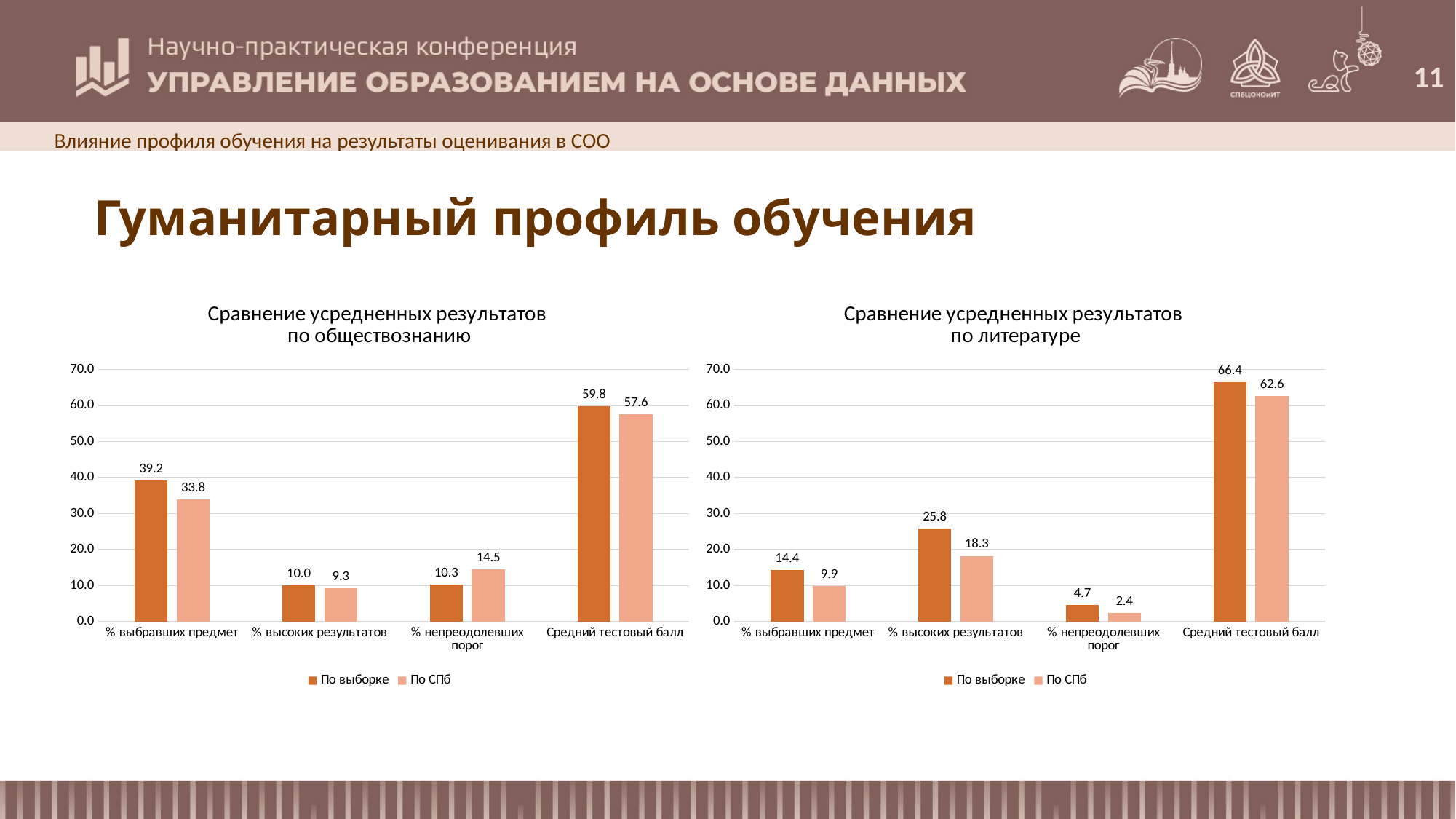
In the chart 'Сравнение усредненных результатов по обществознанию', what is the difference between 'По выборке' and 'По СПб' for '% выбравших предмет'? 5.4 In the chart 'Сравнение усредненных результатов по литературе', what is the difference between 'По выборке' and 'По СПб' for '% высоких результатов'? 7.5 In the chart 'Сравнение усредненных результатов по литературе', what is the value of 'По выборке' for '% непреодолевших порог'? 4.7 In the chart 'Сравнение усредненных результатов по обществознанию', what is the value of 'По выборке' for '% выбравших предмет'? 39.2 In the chart 'Сравнение усредненных результатов по литературе', which category has the lowest 'По СПб' value? % непреодолевших порог In the chart 'Сравнение усредненных результатов по литературе', is the 'По выборке' value for 'Средний тестовый балл' greater or less than 60.0? greater In the chart 'Сравнение усредненных результатов по обществознанию', which is larger for '% непреодолевших порог': 'По выборке' or 'По СПб'? По СПб What type of chart is 'Сравнение усредненных результатов по литературе'? Bar chart How many series does the legend of the chart 'Сравнение усредненных результатов по литературе' list? 2 In the chart 'Сравнение усредненных результатов по обществознанию', which category has the highest 'По выборке' value? Средний тестовый балл In the chart 'Сравнение усредненных результатов по литературе', what is the value of 'По СПб' for 'Средний тестовый балл'? 62.6 How many categories are shown on the x axis of the chart 'Сравнение усредненных результатов по обществознанию'? 4